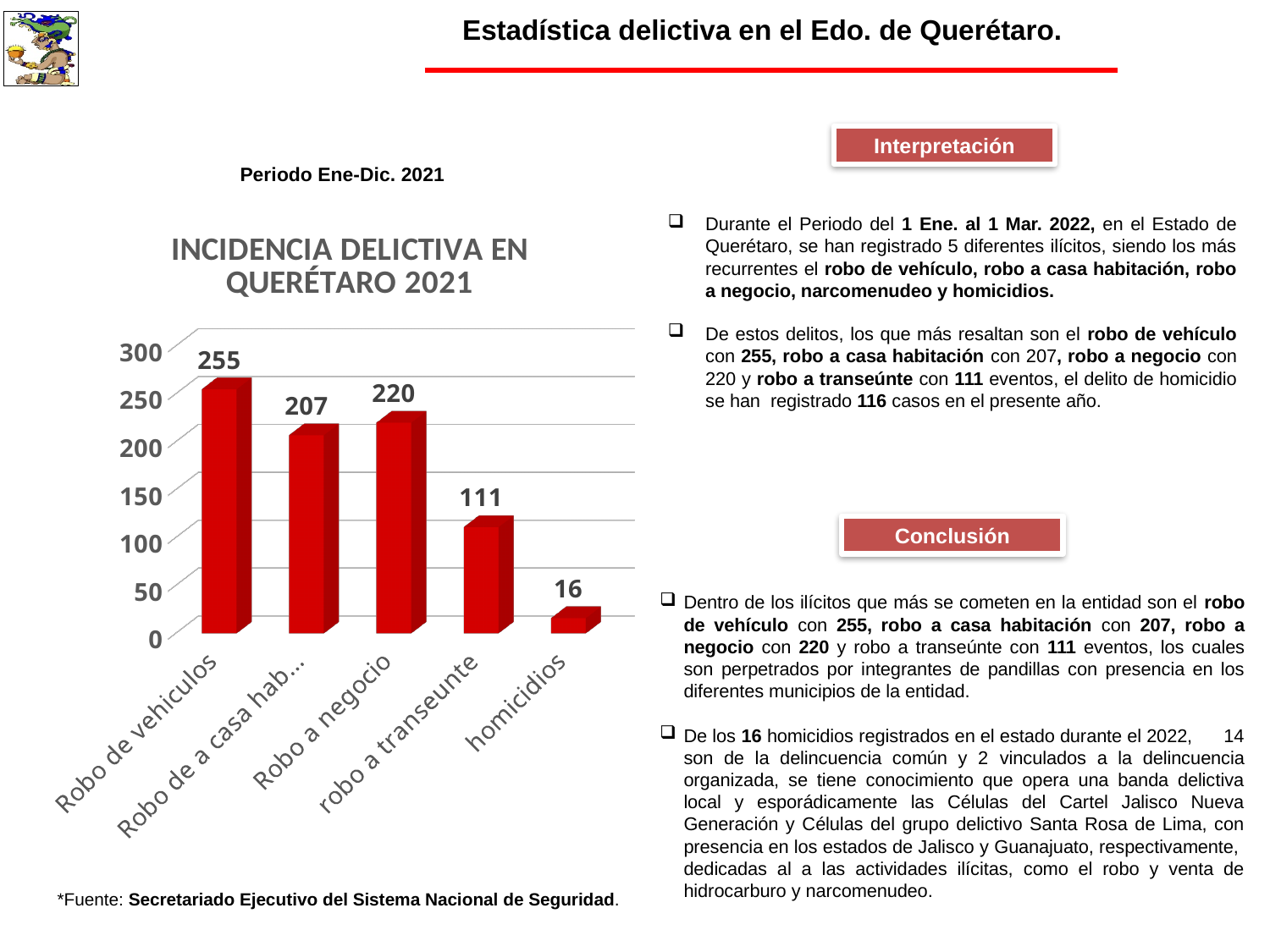
What is the value for Robo a negocio? 220 What is the difference between the values for Robo de vehiculos and Robo a negocio? 35 What is the difference between the values for robo a transeunte and homicidios? 95 How many categories are shown in the chart? 5 Which is larger, the value for Robo a negocio or the value for Robo de a casa hab...? Robo a negocio What is the value for robo a transeunte? 111 Which category has the lowest value? homicidios What is the title of the chart? INCIDENCIA DELICTIVA EN QUERÉTARO 2021 Which category has the highest value? Robo de vehiculos What is the value for Robo de vehiculos? 255 What kind of chart is shown on the slide? bar chart What is the value for homicidios? 16